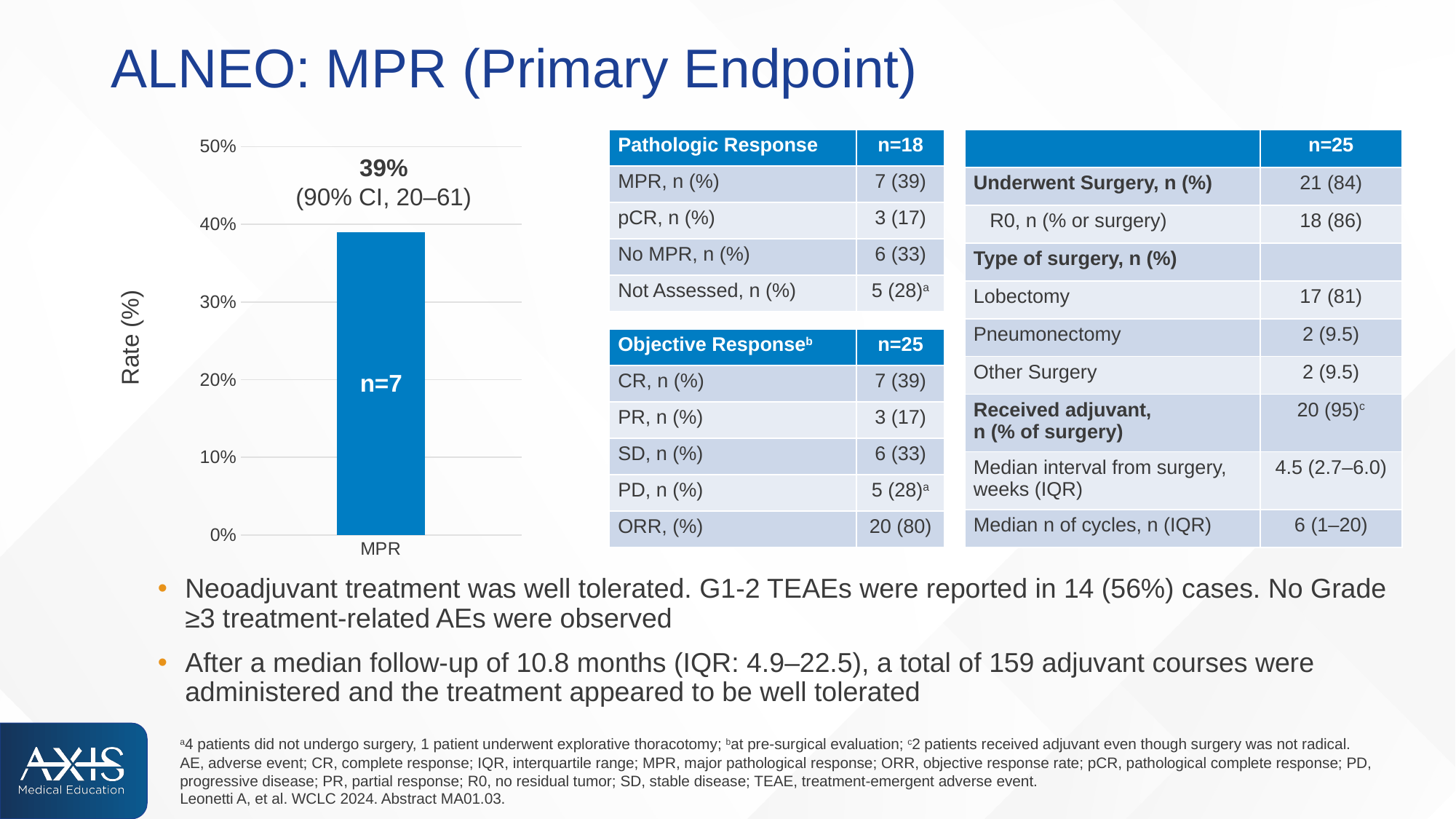
What is the maximum value shown on the y axis of the chart? 50% What is the label of the category on the x axis of the chart? MPR What is the n value printed on the MPR bar? n=7 What is the y-axis title of the chart? Rate (%) Is the value of the MPR bar greater or less than 30%? greater How many bars are plotted in the chart? 1 What 90% confidence interval is printed above the MPR bar? 20–61 Is the value of the MPR bar greater or less than 40%? less What kind of chart is shown on the left of the slide? bar chart What is the MPR rate shown by the bar in the chart? 39%